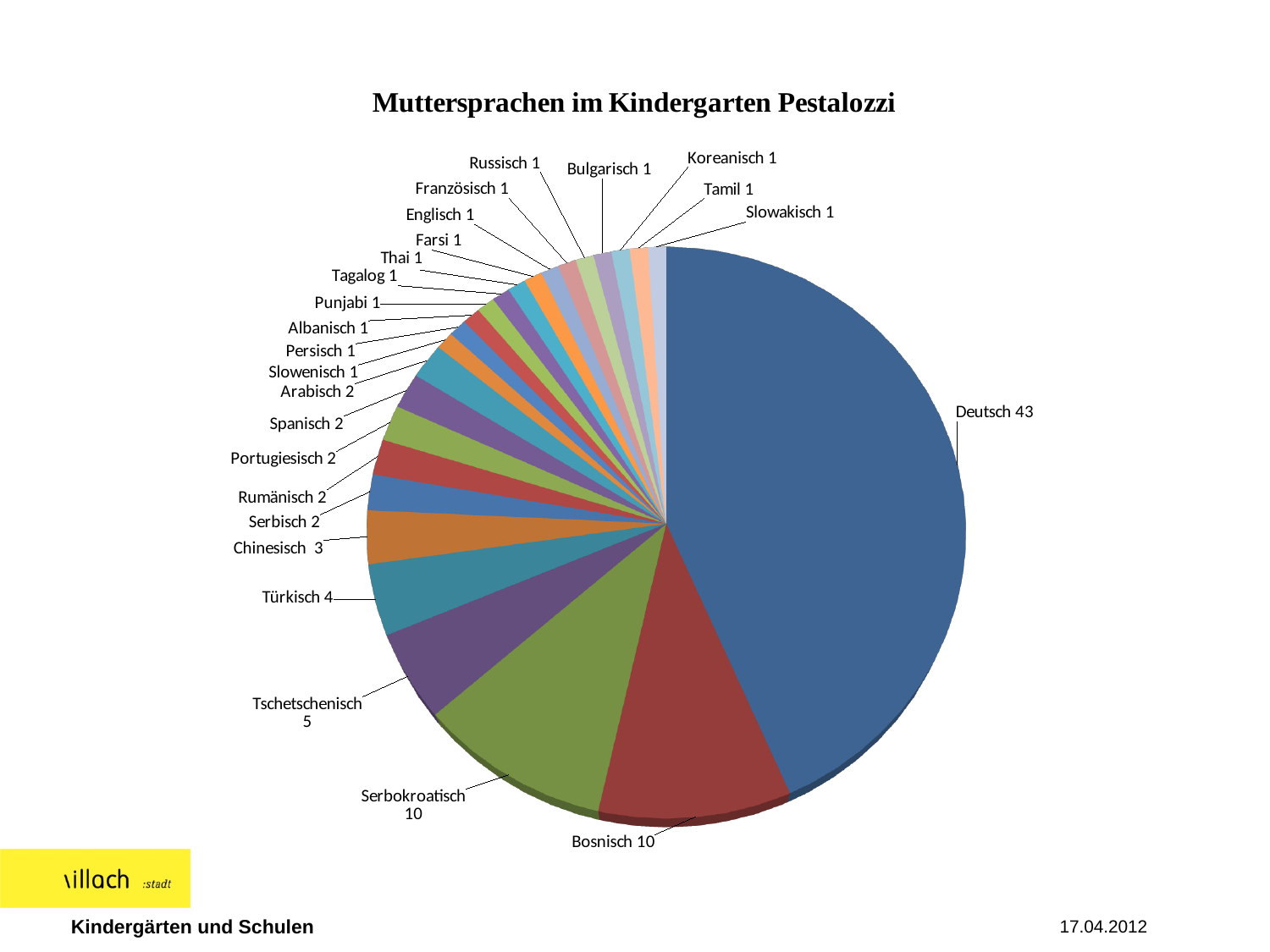
What is the difference between the values for Deutsch and Bosnisch? 33 What is the value for Tschetschenisch? 5 How many languages (slices) are shown in the pie chart? 25 What is the value for Chinesisch? 3 What is the title of the chart? Muttersprachen im Kindergarten Pestalozzi What is the value for Deutsch? 43 What is the difference between the values for Serbokroatisch and Tschetschenisch? 5 Which is larger, the value for Türkisch or the value for Chinesisch? Türkisch What is the value for Türkisch? 4 What type of chart is shown on the slide? Pie chart What is the value for Arabisch? 2 Which language has the largest slice of the pie? Deutsch